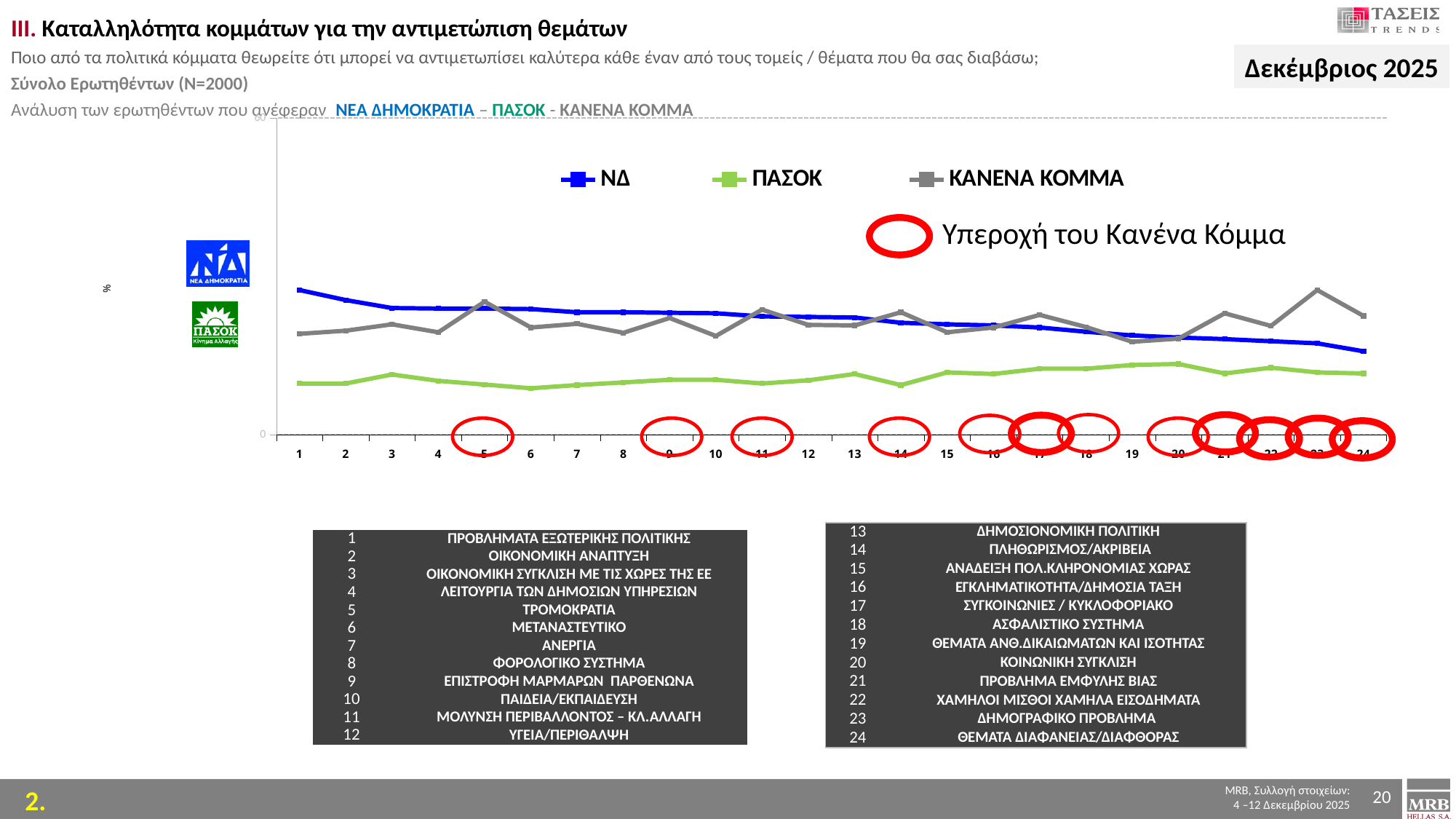
Is the value for ΝΔ at point 1 greater or less than 60? less At point 1, which is larger: the value for ΝΔ or the value for ΠΑΣΟΚ? ΝΔ How many series does the chart legend list? 3 At which point does the ΝΔ line reach its highest value? 1 According to the annotation, what do the red circles on the chart indicate? Υπεροχή του Κανένα Κόμμα At which point does the ΚΑΝΕΝΑ ΚΟΜΜΑ line reach its highest value? 23 Does the ΝΔ line generally rise or fall from point 1 to point 24? Fall Which series has the highest value at point 1? ΝΔ How many numbered points (topics) are plotted along the x axis of the chart? 24 At point 24, which is larger: the value for ΝΔ or the value for ΚΑΝΕΝΑ ΚΟΜΜΑ? ΚΑΝΕΝΑ ΚΟΜΜΑ What kind of chart is shown on the slide? Line chart Which series has the lowest value at point 24? ΠΑΣΟΚ